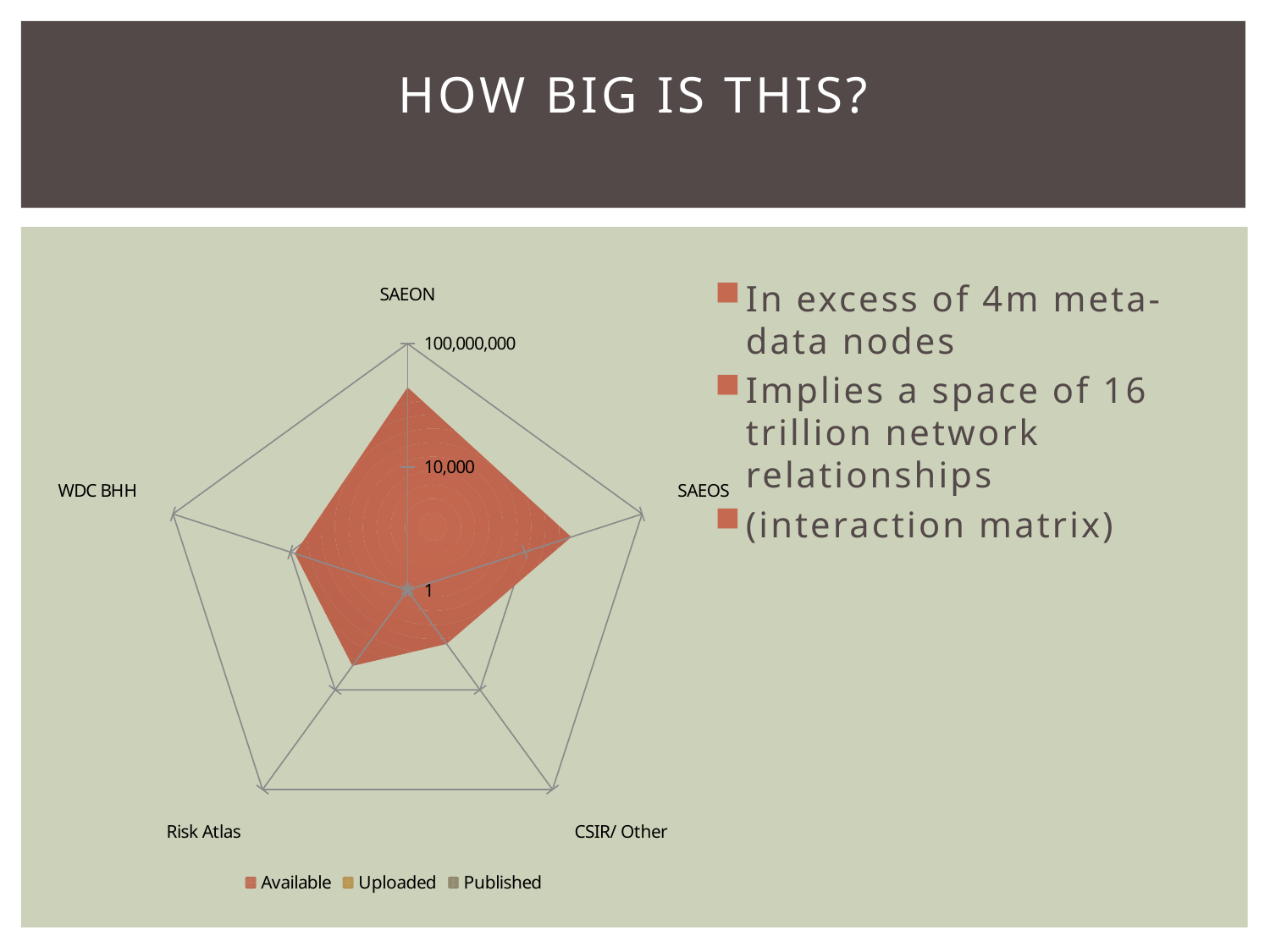
How many series does the chart legend list? 3 Which has the larger Available value, SAEON or CSIR/ Other? SAEON What is the highest value label shown on the chart's axis? 100,000,000 Which category has the highest Available value on the radar chart? SAEON Which has the larger Available value, SAEOS or CSIR/ Other? SAEOS How many categories are plotted on the radar chart? 5 Is the Available value for SAEON greater or less than 100,000,000? less Which series are listed in the chart legend? Available, Uploaded, Published Is the Available value for SAEOS greater or less than 10,000? greater What kind of chart is shown on the slide? Radar chart Is the Available value for SAEON greater or less than 10,000? greater